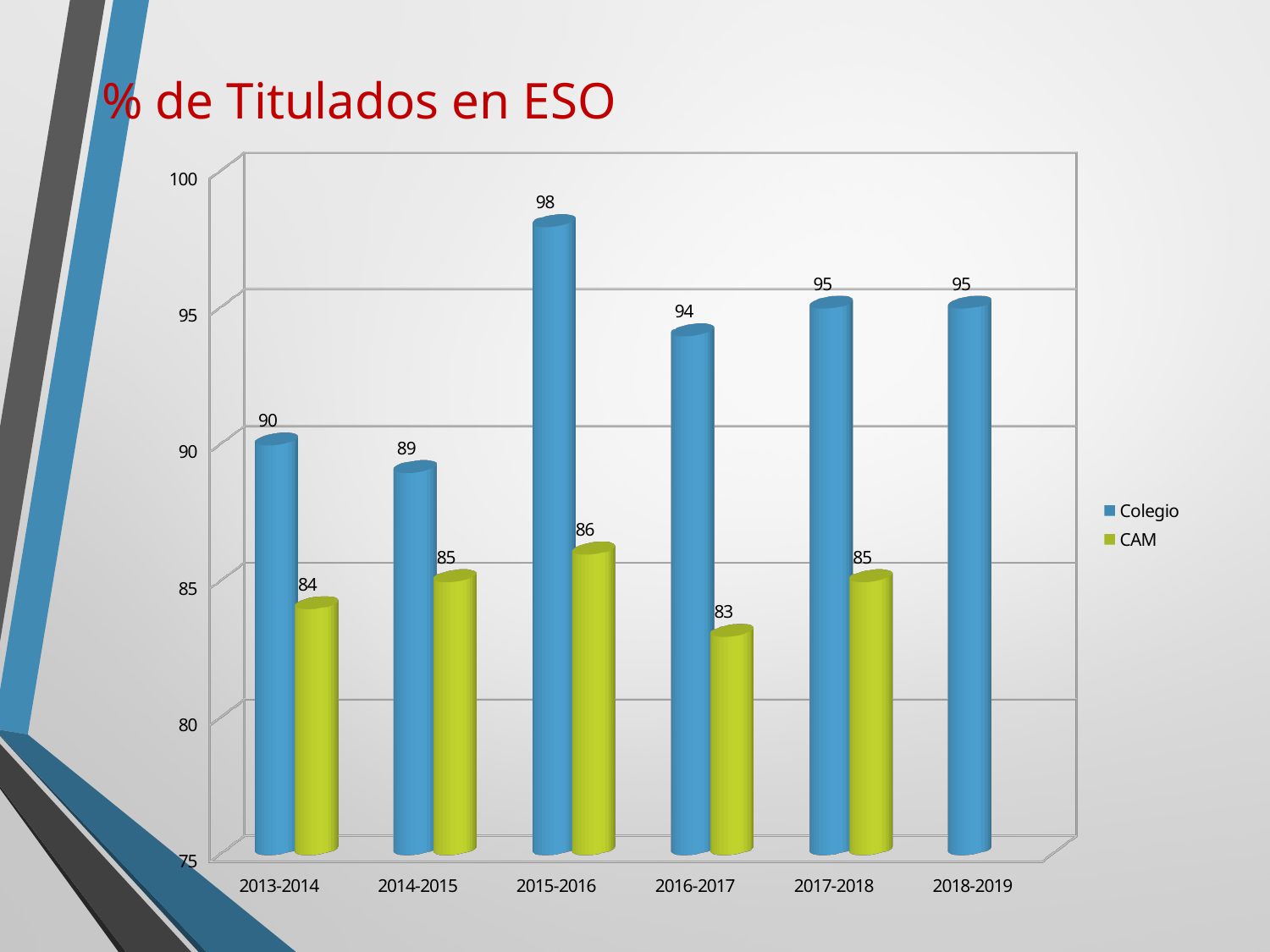
How many series does the legend list? 2 What kind of chart is shown on the slide? Bar chart What is the Colegio value for 2015-2016? 98 What is the CAM value for 2016-2017? 83 What is the difference between the Colegio and CAM values in 2015-2016? 12 What is the Colegio value for 2018-2019? 95 In which year is the Colegio value highest? 2015-2016 In which year is the CAM value lowest? 2016-2017 How many school years are shown on the x axis? 6 Which is larger in 2013-2014, the Colegio value or the CAM value? Colegio Is the Colegio value for 2014-2015 greater or less than 85? greater What is the title of the chart? % de Titulados en ESO